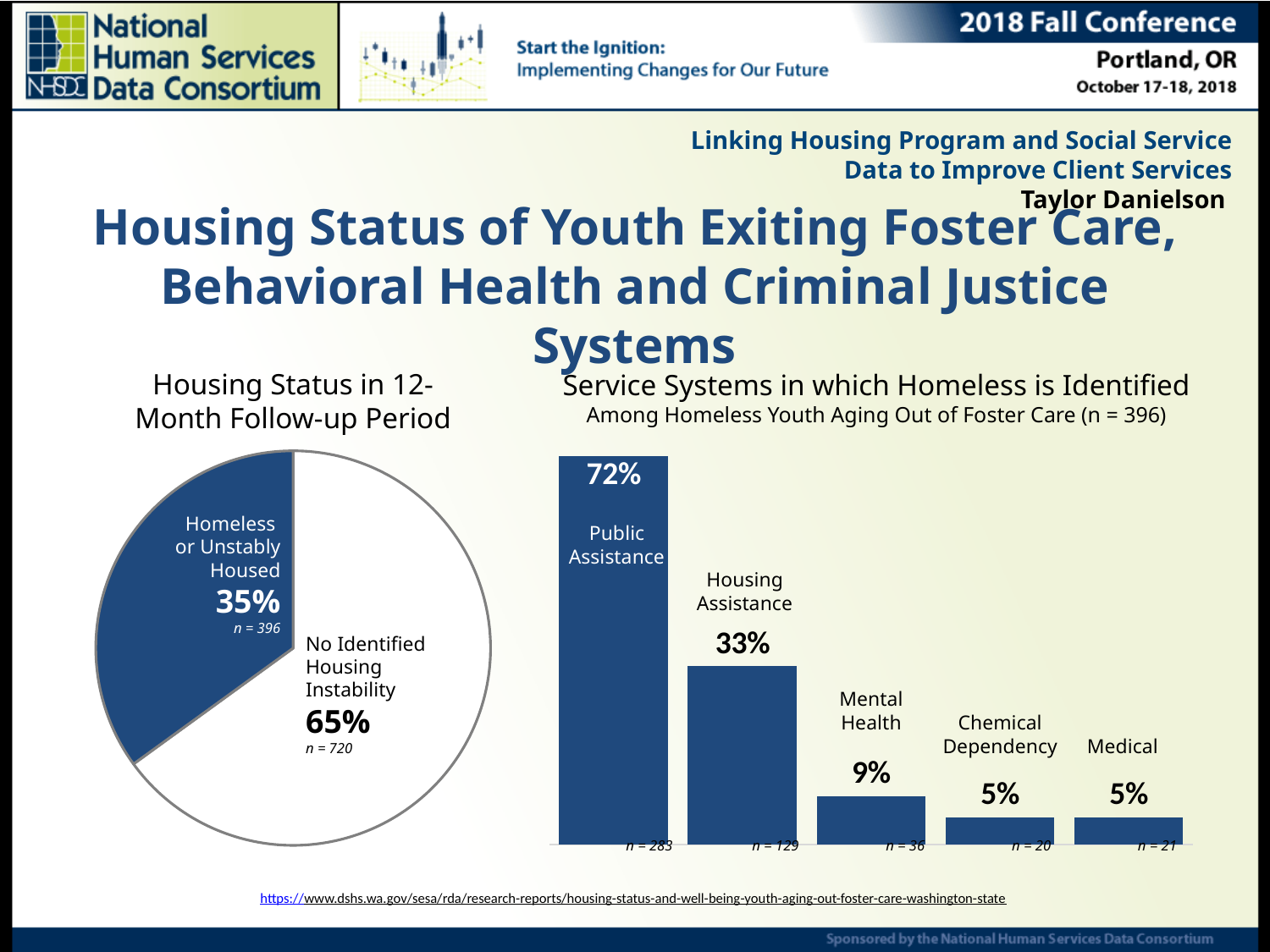
In the 'Service Systems in which Homeless is Identified' chart, which service system has the highest value? Public Assistance In the 'Service Systems in which Homeless is Identified' chart, what is the difference between Public Assistance and Housing Assistance? 39% In the 'Housing Status in 12-Month Follow-up Period' chart, what share of youth were Homeless or Unstably Housed? 35% In the 'Housing Status in 12-Month Follow-up Period' chart, what share of youth had No Identified Housing Instability? 65% In the 'Service Systems in which Homeless is Identified' chart, what is the value for Mental Health? 9% In the 'Housing Status in 12-Month Follow-up Period' chart, what is the n for the Homeless or Unstably Housed slice? n = 396 In the 'Service Systems in which Homeless is Identified' chart, how many service systems are shown? 5 In the 'Service Systems in which Homeless is Identified' chart, which is larger, Housing Assistance or Mental Health? Housing Assistance In the 'Service Systems in which Homeless is Identified' chart, what is the value for Housing Assistance? 33% In the 'Service Systems in which Homeless is Identified' chart, what is the value for Public Assistance? 72% What kind of chart is 'Housing Status in 12-Month Follow-up Period'? Pie chart What kind of chart is 'Service Systems in which Homeless is Identified'? Bar chart